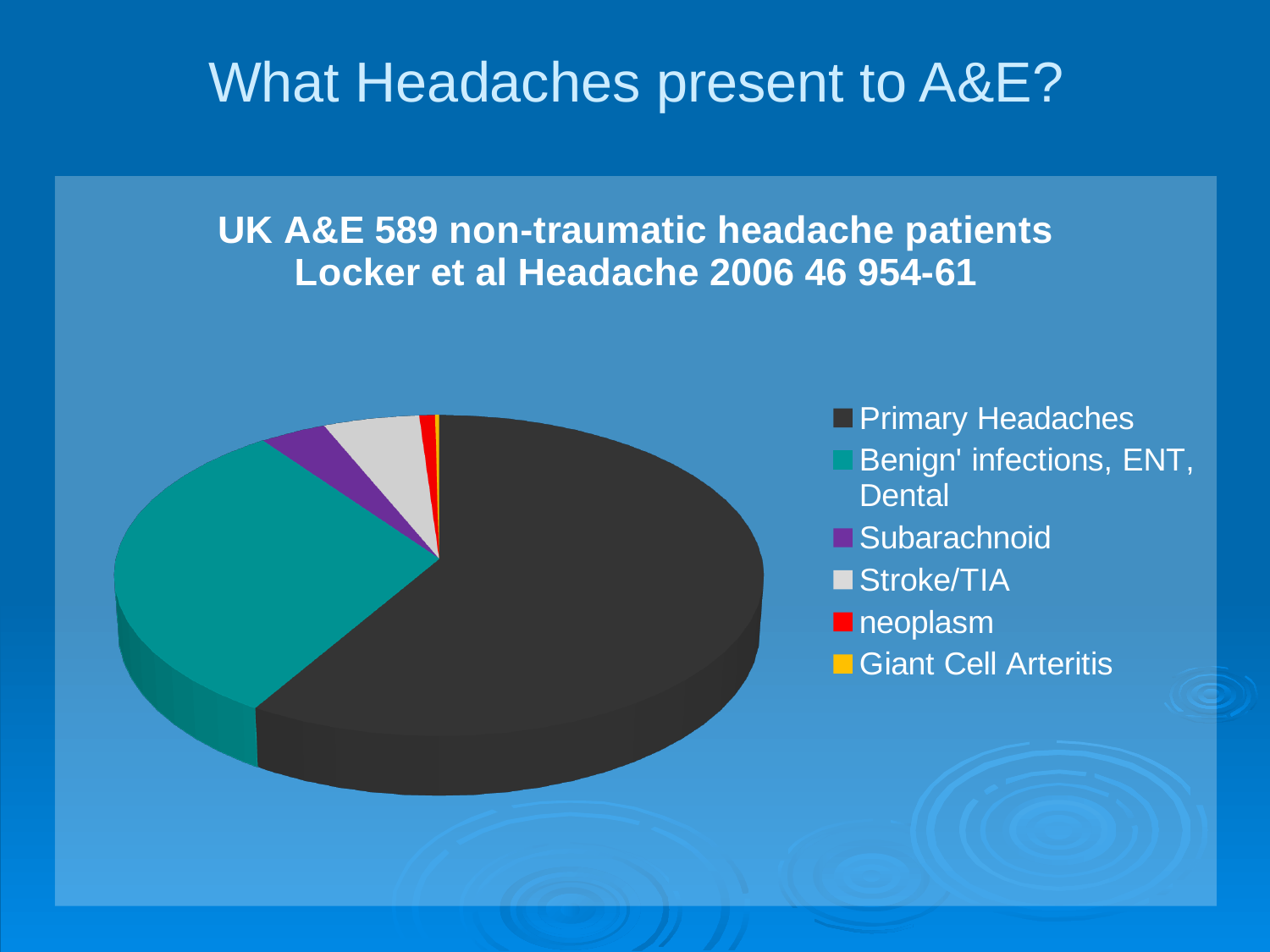
What is the title of the pie chart? UK A&E 589 non-traumatic headache patients Locker et al Headache 2006 46 954-61 Which category has the smallest slice of the pie chart? Giant Cell Arteritis Which slice is larger: neoplasm or Giant Cell Arteritis? neoplasm What kind of chart is shown on the slide? Pie chart Which slice is larger: Stroke/TIA or neoplasm? Stroke/TIA Is the Primary Headaches slice greater or less than half of the pie? greater Which category has the largest slice of the pie chart? Primary Headaches How many categories does the pie chart show? 6 What colour represents Subarachnoid in the pie chart legend? Purple Which slice is larger: Primary Headaches or Benign' infections, ENT, Dental? Primary Headaches